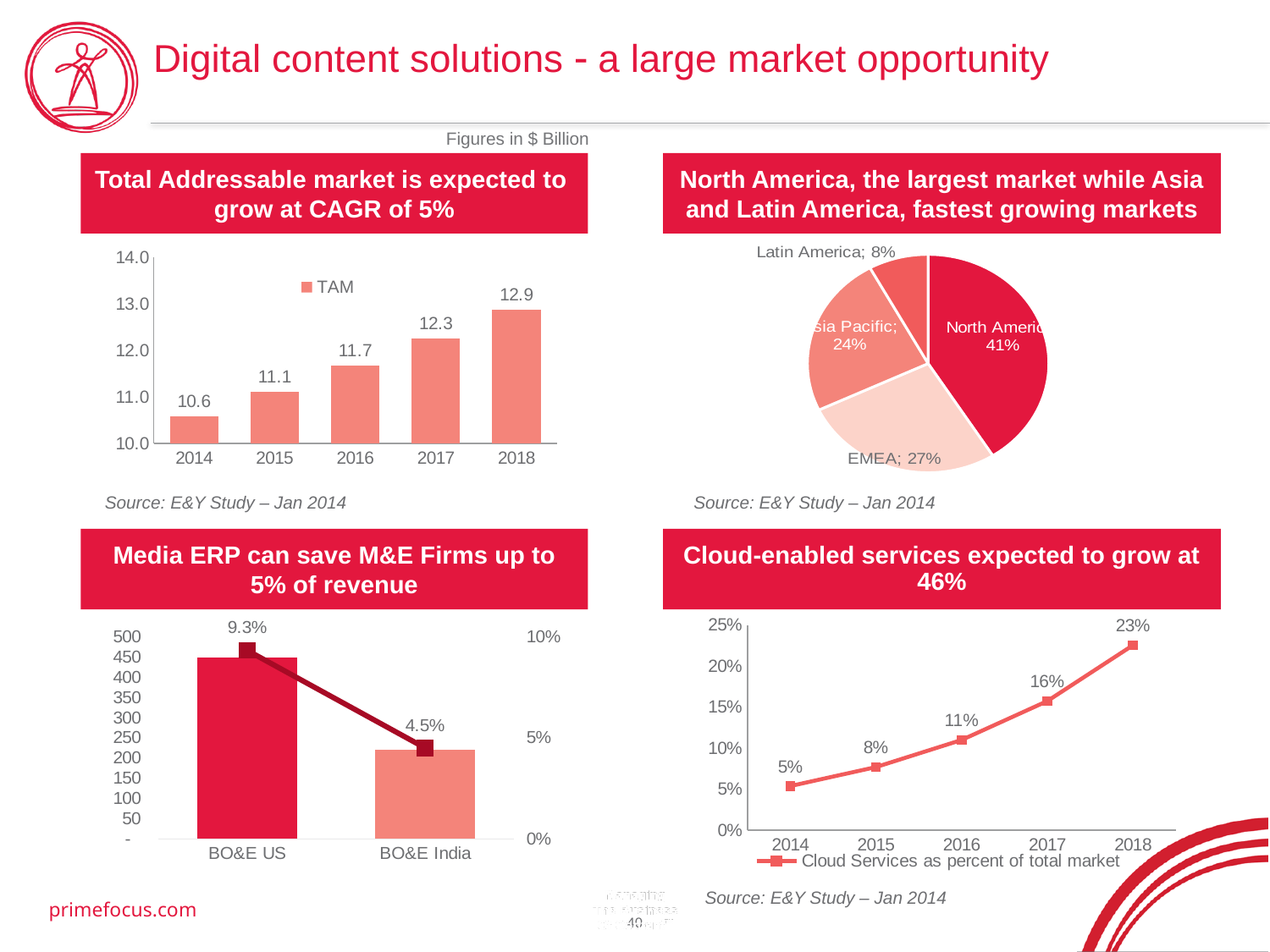
In the 'Cloud-enabled services' chart, what is the difference between the 2018 and 2014 values? 18% In the 'Total Addressable market' chart, what is the difference between the TAM values for 2018 and 2014? 2.3 In the pie chart titled 'North America, the largest market...', how many regions are shown? 4 In the 'Media ERP can save M&E Firms' chart, is the bar value for BO&E US greater or less than 400? greater In the 'Total Addressable market' chart, which year has the highest TAM value? 2018 In the pie chart titled 'North America, the largest market...', what share does EMEA have? 27% In the pie chart titled 'North America, the largest market...', which region has the smallest slice? Latin America What type of chart is the 'Cloud-enabled services expected to grow at 46%' chart? line chart In the 'Media ERP can save M&E Firms' chart, what percentage is labelled for BO&E India? 4.5% In the 'Total Addressable market' chart, do the TAM values rise or fall from 2014 to 2018? rise In the 'Total Addressable market' chart, what is the TAM value for 2016? 11.7 In the 'Cloud-enabled services' chart, what is the value for 2017? 16%